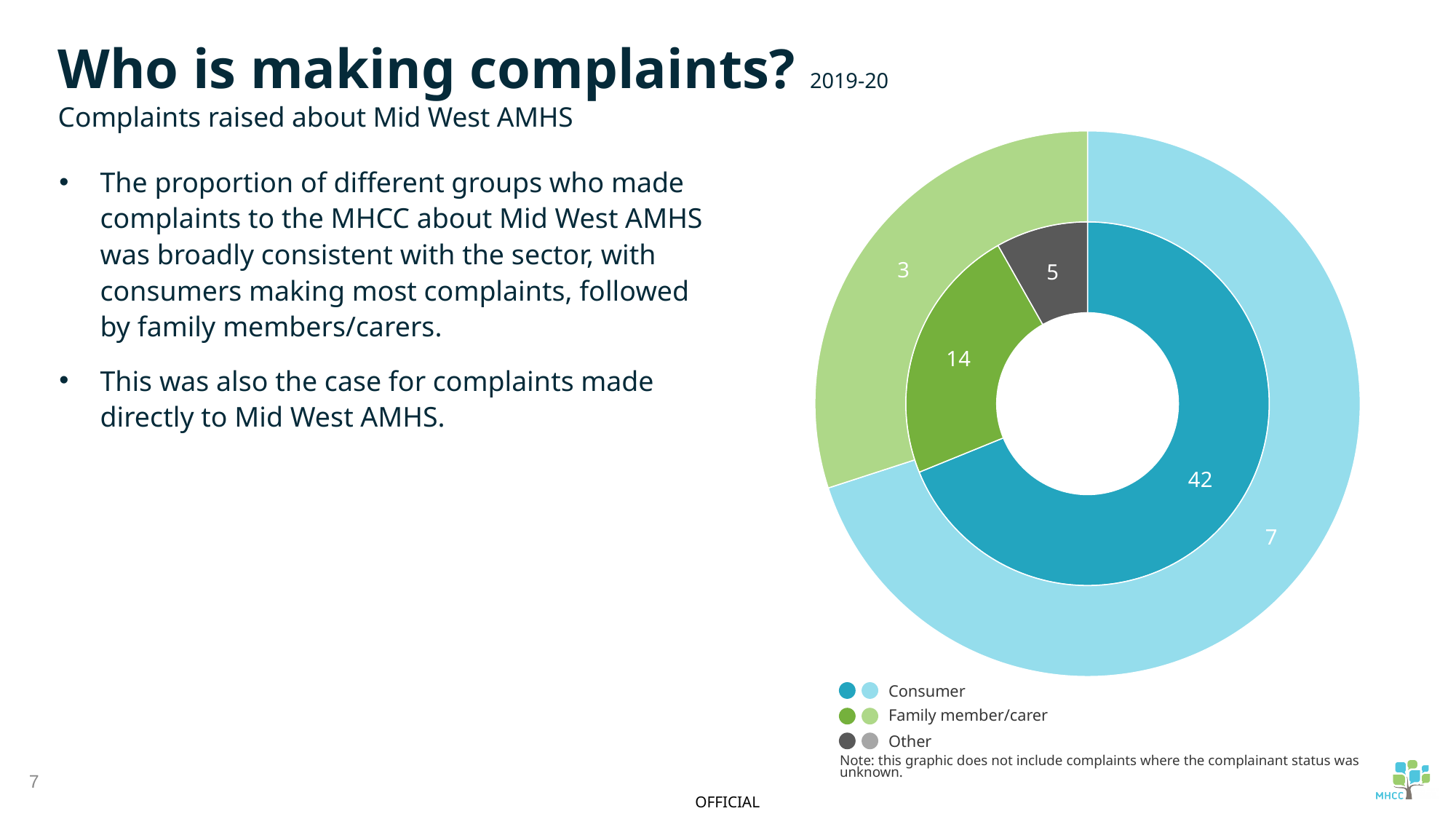
In the outer ring of the doughnut chart, what is the value for Family member/carer? 3 Which group has the smallest value in the inner ring of the doughnut chart? Other In the inner ring of the doughnut chart, what is the value for Other? 5 In the outer ring of the doughnut chart, what is the value for Consumer? 7 In the inner ring of the doughnut chart, what is the value for Family member/carer? 14 What type of chart is shown on the slide? Doughnut chart In the inner ring of the doughnut chart, what is the value for Consumer? 42 How many groups does the chart legend list? 3 In the outer ring, which is larger: the Consumer value or the Family member/carer value? Consumer Which group has the largest value in the inner ring of the doughnut chart? Consumer In the inner ring, how much larger is the Consumer value than the Family member/carer value? 28 What colour represents Consumer in the doughnut chart? Blue